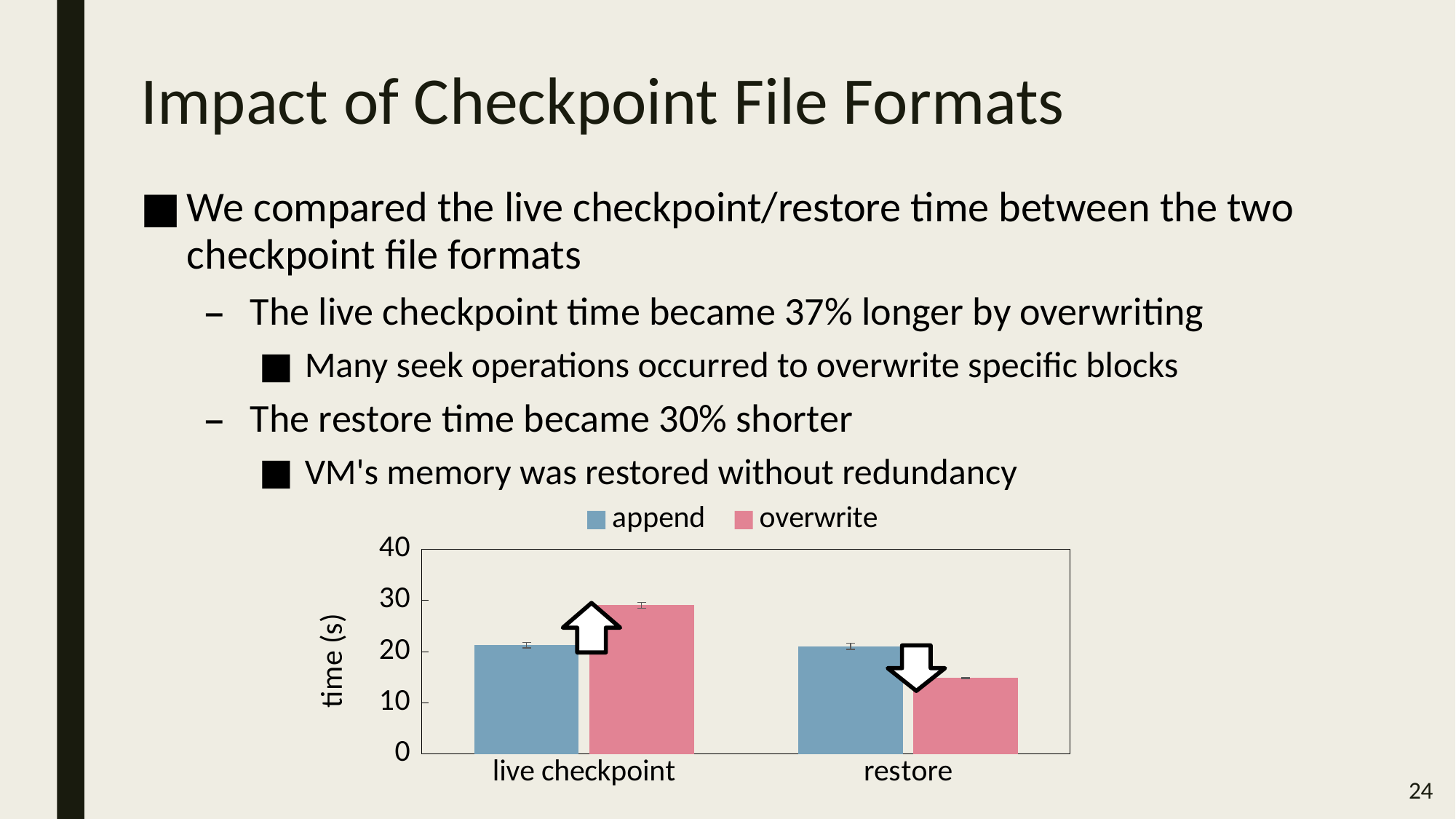
What are the two series named in the chart legend? append and overwrite What is the label of the y axis of the chart? time (s) How many series does the chart legend list? 2 What kind of chart is shown on the slide? bar chart Which bar in the chart is the tallest? overwrite for live checkpoint For restore, which series has the larger value, append or overwrite? append How many categories are shown on the x axis of the chart? 2 Is the value for append at live checkpoint greater or less than 30? less Which bar in the chart is the shortest? overwrite for restore For live checkpoint, which series has the larger value, append or overwrite? overwrite Is the value for overwrite at live checkpoint greater or less than 20? greater Is the value for overwrite at restore greater or less than 20? less